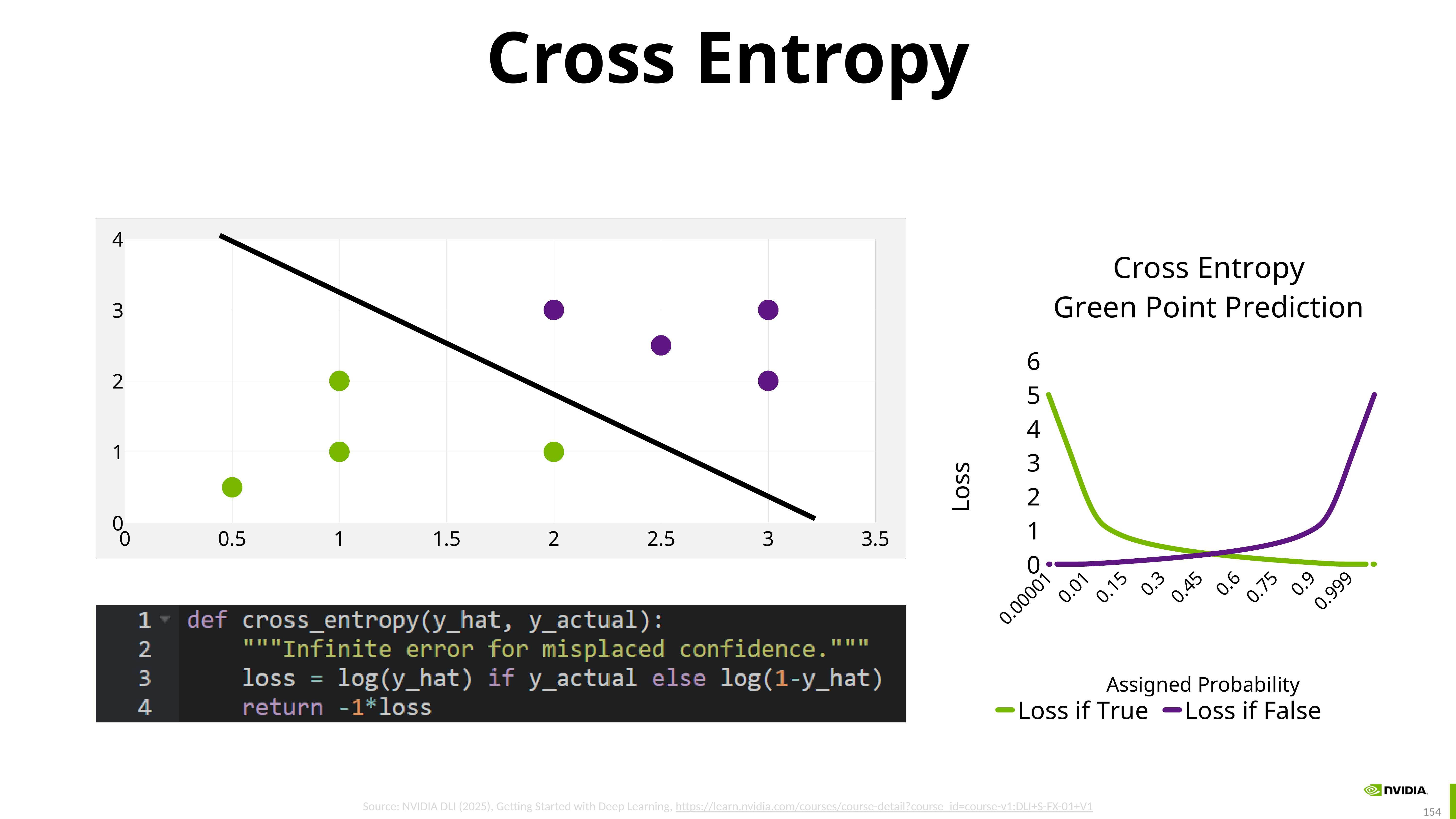
On the left scatter chart, how many purple points are plotted? 4 On the right chart titled 'Cross Entropy Green Point Prediction', does the 'Loss if True' series rise or fall as assigned probability increases? fall On the right chart titled 'Cross Entropy Green Point Prediction', is the 'Loss if False' value at 0.999 greater or less than 4? greater On the left scatter chart, how many green points are plotted? 4 On the right chart titled 'Cross Entropy Green Point Prediction', does the 'Loss if False' series rise or fall as assigned probability increases? rise On the right chart titled 'Cross Entropy Green Point Prediction', how many labelled points are on the x axis? 9 On the right chart titled 'Cross Entropy Green Point Prediction', how many series does the legend list? 2 On the right chart titled 'Cross Entropy Green Point Prediction', is the 'Loss if True' value at 0.999 greater or less than 1? less On the right chart titled 'Cross Entropy Green Point Prediction', what is the label of the y axis? Loss On the right chart titled 'Cross Entropy Green Point Prediction', what are the two legend entries? Loss if True, Loss if False On the right chart titled 'Cross Entropy Green Point Prediction', is the 'Loss if True' value at 0.00001 greater or less than 4? greater On the right chart titled 'Cross Entropy Green Point Prediction', at an assigned probability of 0.01, which series has the larger loss? Loss if True